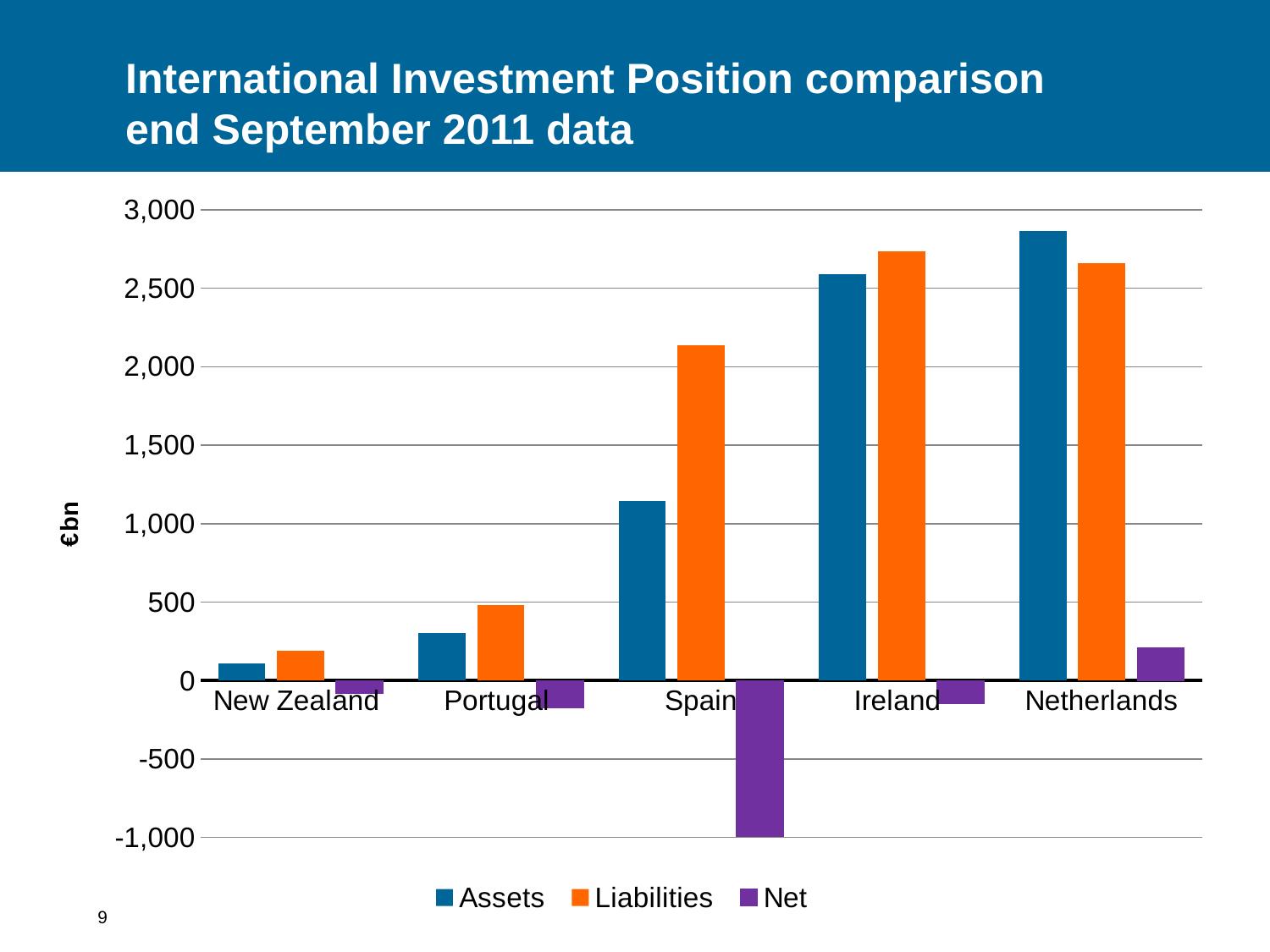
For Netherlands, which is larger: Assets or Liabilities? Assets What is the label on the vertical axis? €bn Which country has the lowest Liabilities value? New Zealand What kind of chart is shown on the slide? bar chart Which country has the highest Assets value? Netherlands For Spain, which is larger: Assets or Liabilities? Liabilities Is the Net value for Spain greater or less than -500? less How many countries are shown on the x axis? 5 How many series does the legend list? 3 Which country has the lowest Net value? Spain Is the Liabilities value for Spain greater or less than 2,000? greater